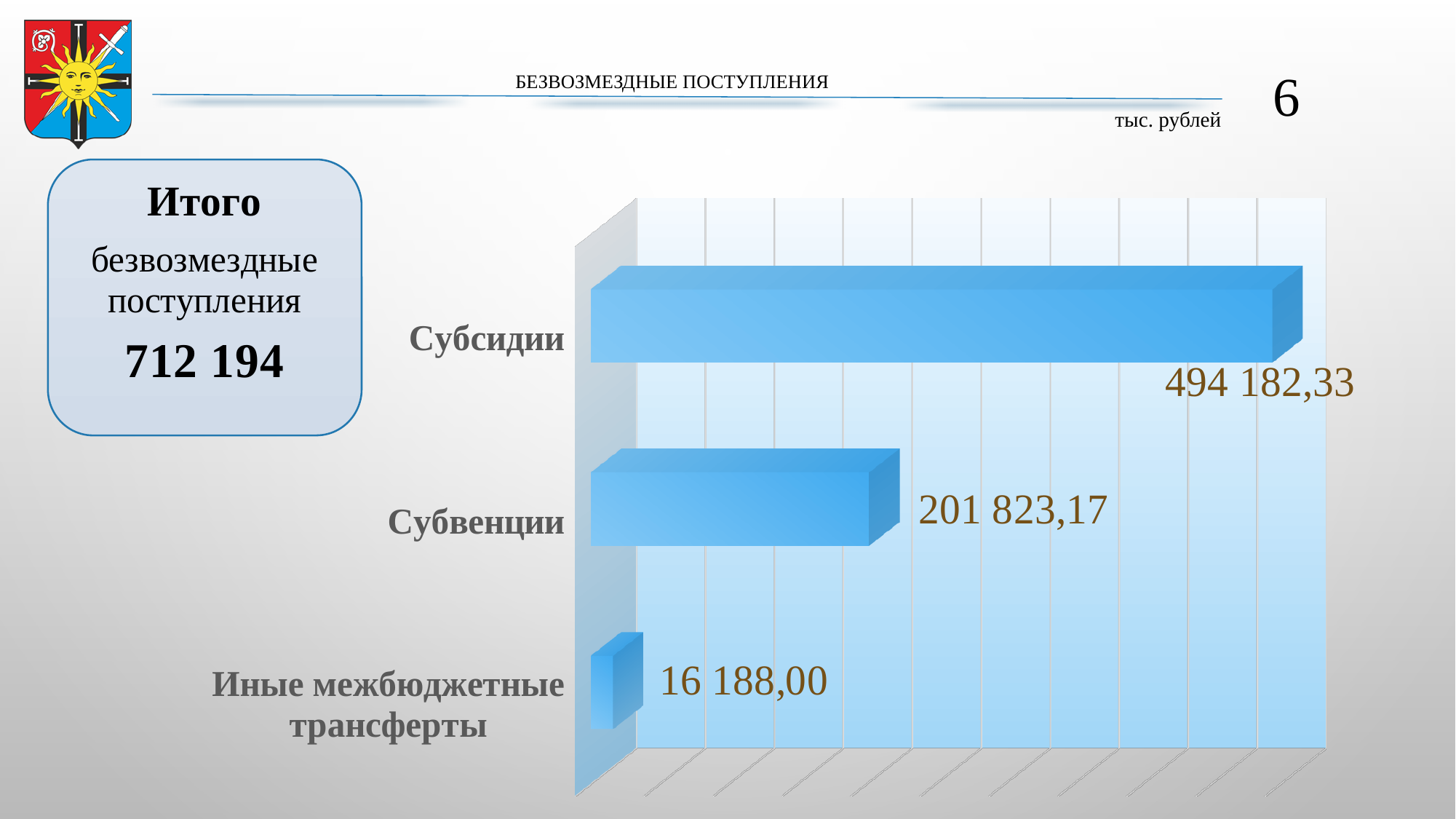
What is the difference between the values for Субвенции and Иные межбюджетные трансферты? 185 635,17 What is the difference between the values for Субсидии and Субвенции? 292 359,16 What is the value for Иные межбюджетные трансферты? 16 188,00 Which is larger, the value for Субвенции or the value for Иные межбюджетные трансферты? Субвенции What is the title of the chart? БЕЗВОЗМЕЗДНЫЕ ПОСТУПЛЕНИЯ What is the value for Субвенции? 201 823,17 Which category has the highest value? Субсидии What is the value for Субсидии? 494 182,33 What kind of chart is shown on the slide? Bar chart Which category has the lowest value? Иные межбюджетные трансферты In what units are the chart values given? тыс. рублей How many categories are shown in the chart? 3